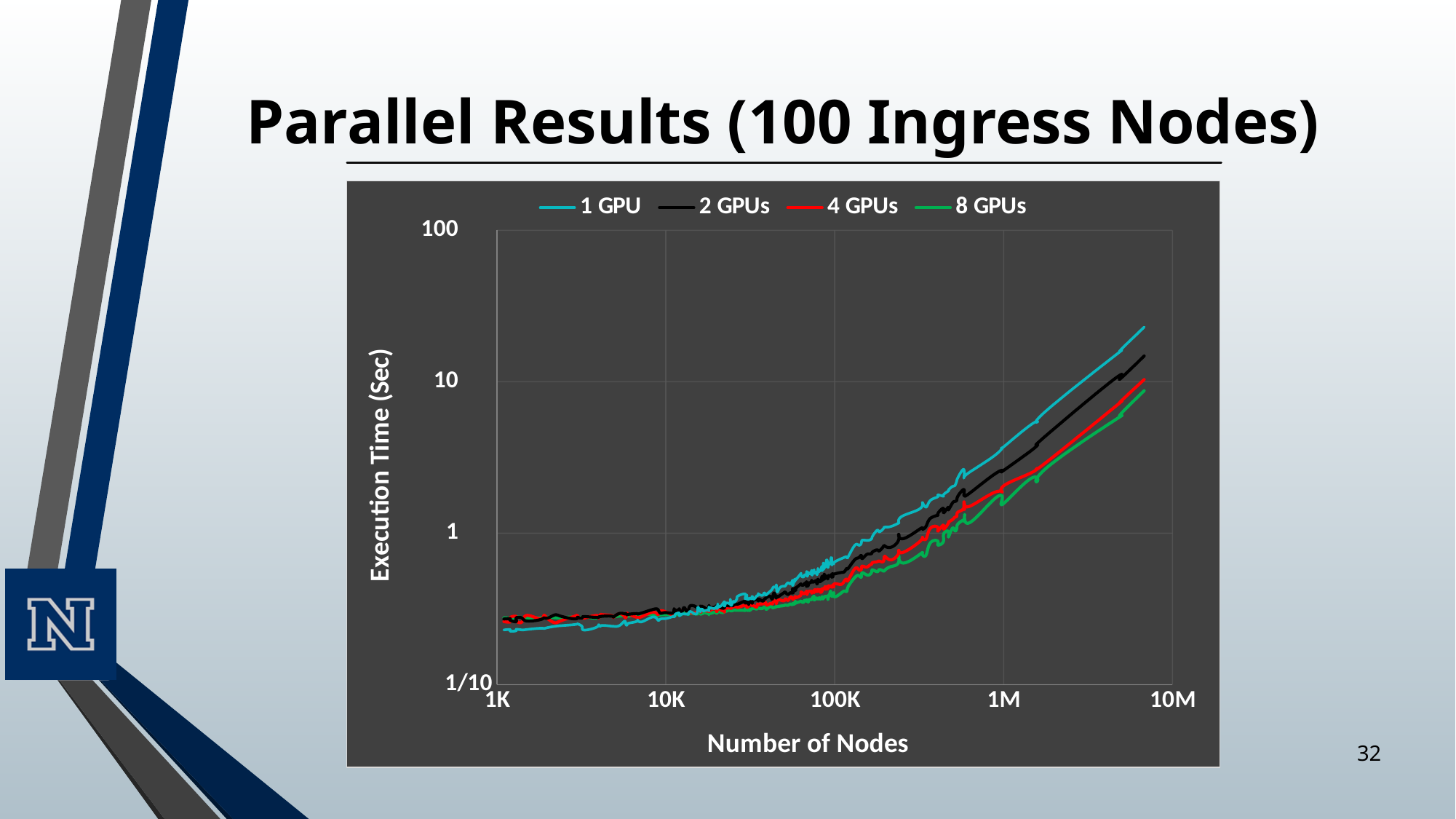
Is the execution time for 2 GPUs at 100K nodes greater or less than 1 second? less Which series has the highest execution time at the largest number of nodes? 1 GPU What is the title of the chart on the slide? Parallel Results (100 Ingress Nodes) At the largest number of nodes, which has the higher execution time: 1 GPU or 8 GPUs? 1 GPU Does execution time rise or fall as the number of nodes increases? rise At the largest number of nodes, which has the higher execution time: 2 GPUs or 4 GPUs? 2 GPUs Is the execution time for 1 GPU at 1M nodes greater or less than 1 second? greater How many series does the legend list? 4 Is the execution time for 8 GPUs at 10K nodes greater or less than 1 second? less What is the label of the x axis? Number of Nodes What kind of chart is shown on the slide? line chart